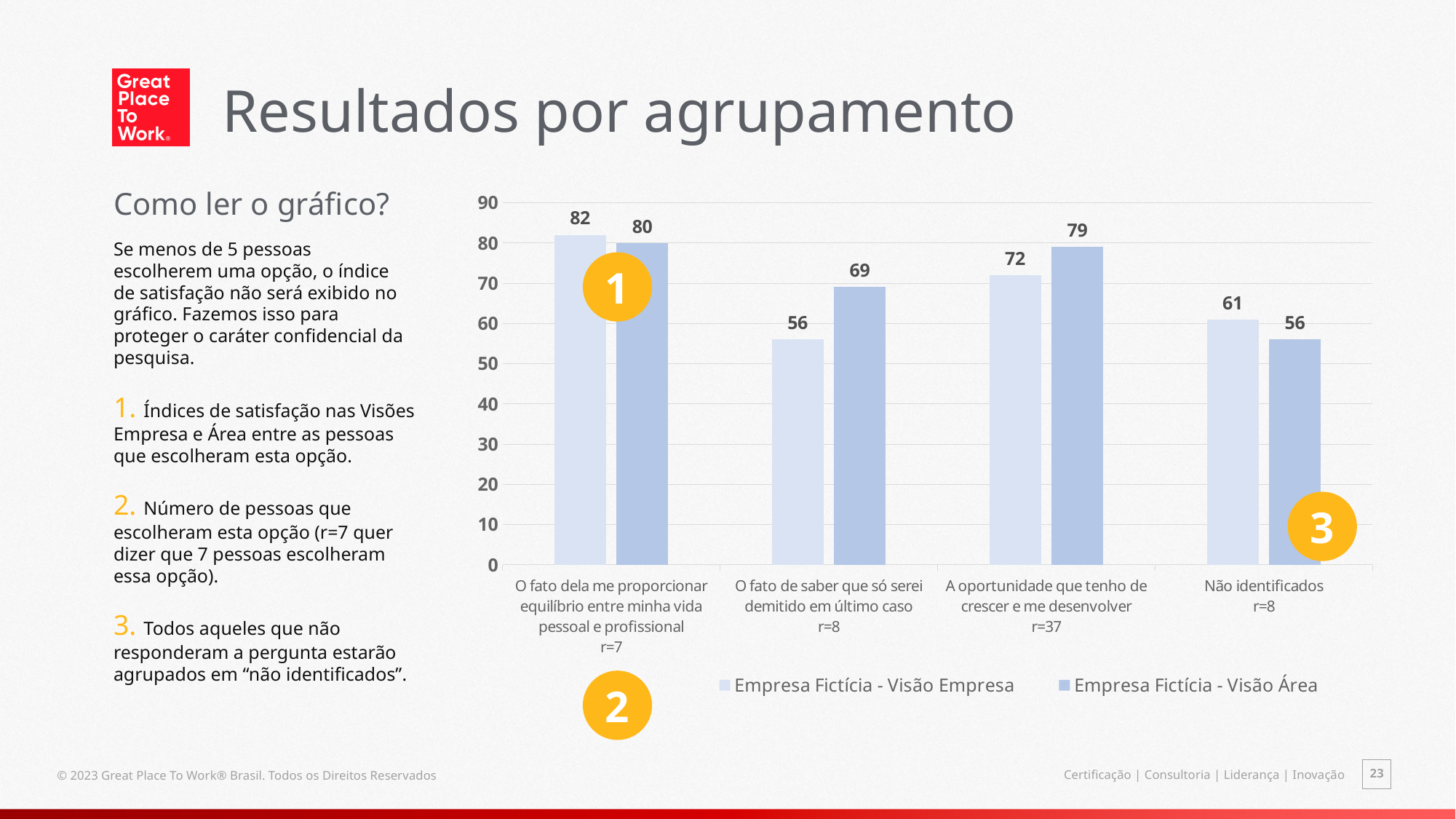
In the category 'O fato de saber que só serei demitido em último caso', which series has the larger value? Empresa Fictícia - Visão Área What is the value for 'Empresa Fictícia - Visão Empresa' in the category 'O fato dela me proporcionar equilíbrio entre minha vida pessoal e profissional'? 82 How many respondents (r) are indicated for the category 'A oportunidade que tenho de crescer e me desenvolver'? r=37 What is the difference between the 'Visão Empresa' and 'Visão Área' values in the category 'A oportunidade que tenho de crescer e me desenvolver'? 7 What is the value for 'Empresa Fictícia - Visão Área' in the category 'O fato de saber que só serei demitido em último caso'? 69 How many series does the legend list? 2 Is the value for 'Empresa Fictícia - Visão Empresa' in 'Não identificados' greater or less than 50? greater What is the value for 'Empresa Fictícia - Visão Área' in the category 'Não identificados'? 56 Which category has the lowest value for 'Empresa Fictícia - Visão Área'? Não identificados What kind of chart is shown on the slide? Bar chart Which category has the highest value for 'Empresa Fictícia - Visão Empresa'? O fato dela me proporcionar equilíbrio entre minha vida pessoal e profissional How many categories are shown on the x axis of the chart? 4